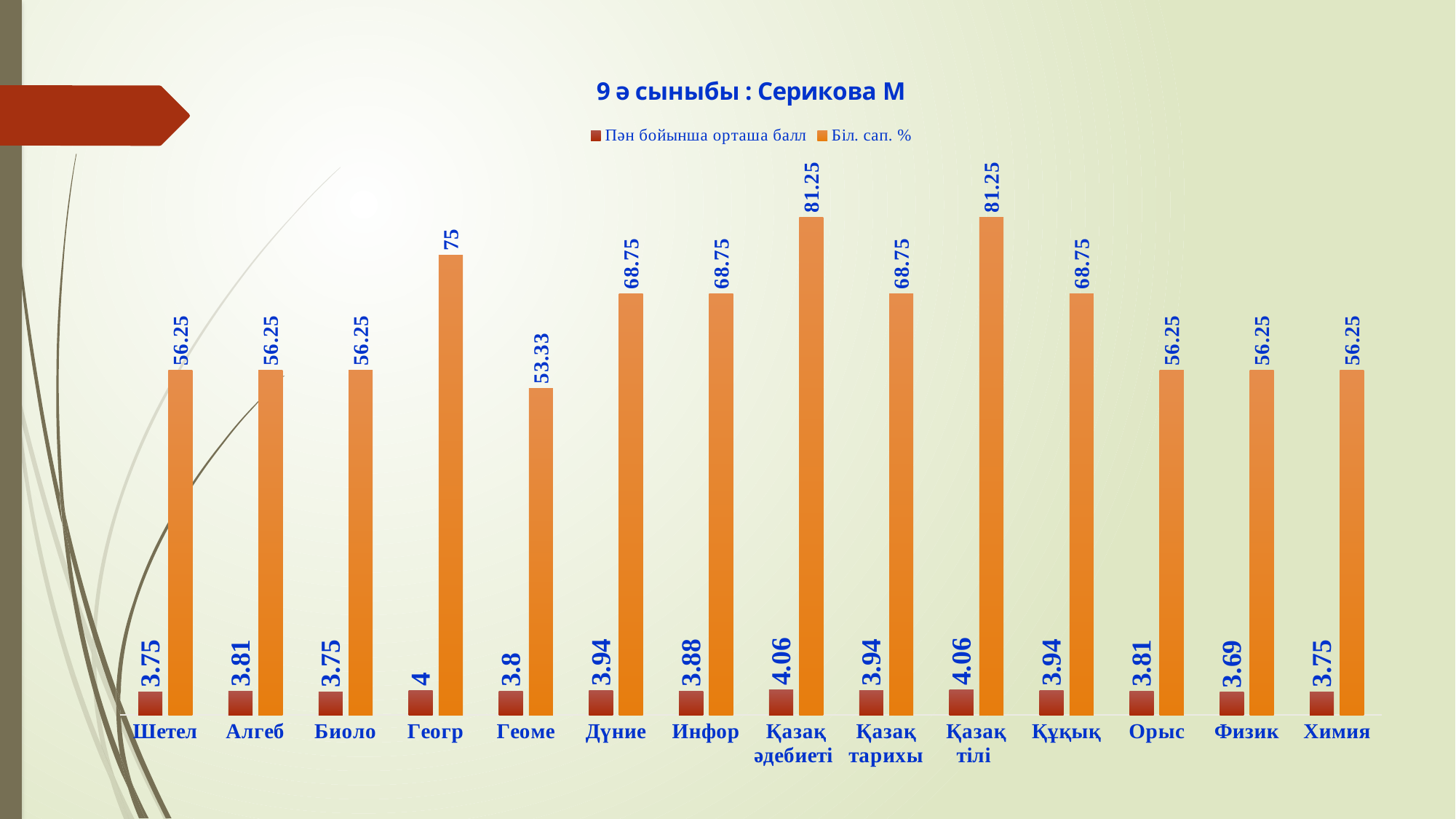
What is the difference between the Біл. сап. % values for Қазақ тілі and Құқық? 12.5 What is the value of Пән бойынша орташа балл for Инфор? 3.88 What type of chart is shown on the slide? bar chart What is the value of Біл. сап. % for Геогр? 75 How many series does the legend list? 2 What is the title of the chart? 9 ә сыныбы : Серикова М Which subject has the lowest Біл. сап. % value? Геоме Which is larger, the Біл. сап. % value for Геогр or for Дүние? Геогр What is the difference between the Пән бойынша орташа балл values for Қазақ әдебиеті and Шетел? 0.31 What is the value of Біл. сап. % for Геоме? 53.33 How many subject categories are shown on the x axis? 14 Which subject has the lowest Пән бойынша орташа балл value? Физик